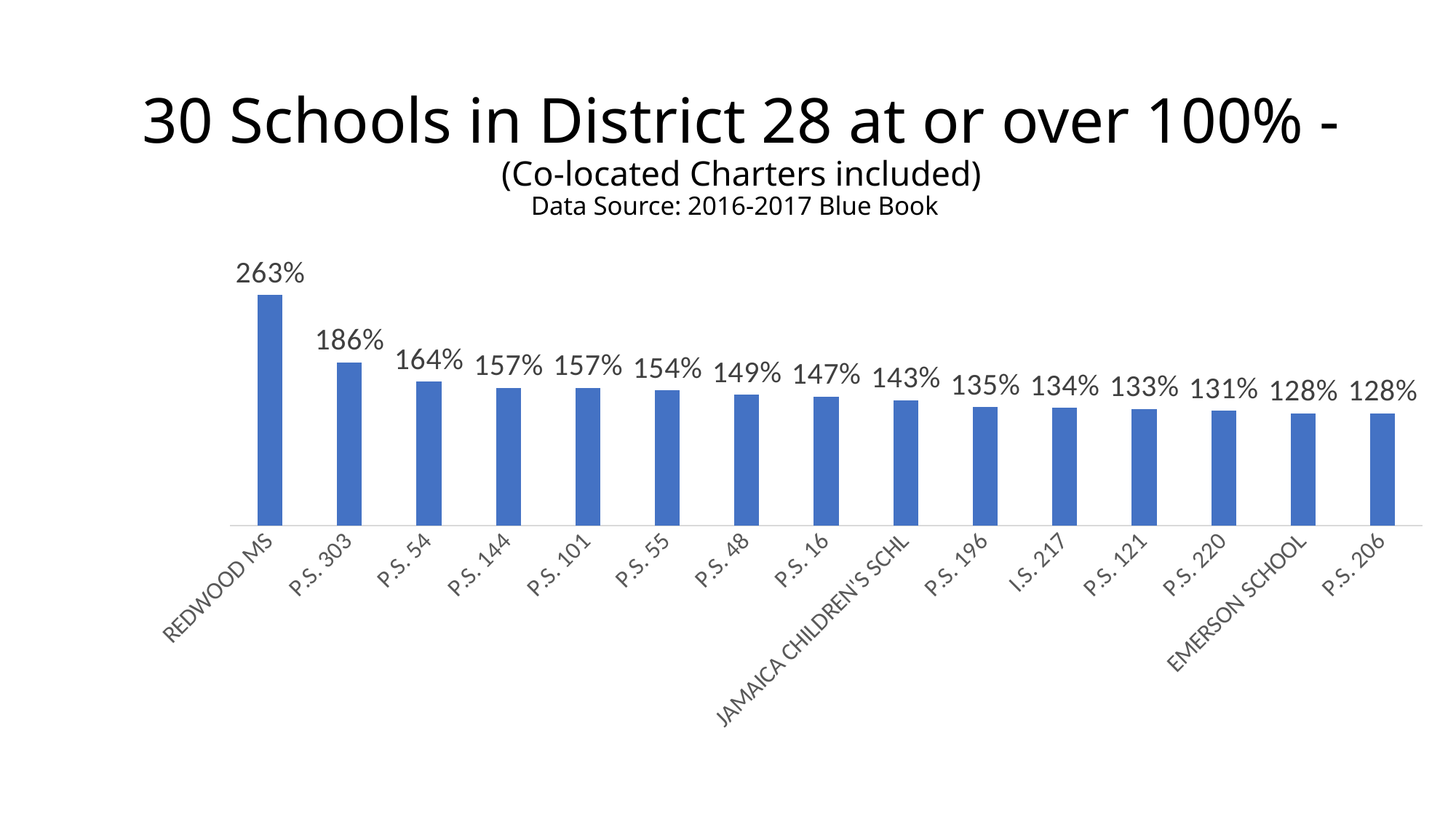
What is the value for P.S. 303? 186% What is the value for REDWOOD MS? 263% What is the value for JAMAICA CHILDREN'S SCHL? 143% What is the value for EMERSON SCHOOL? 128% What kind of chart is shown on the slide? bar chart Which school has the highest value? REDWOOD MS Do the values rise or fall from left to right along the x axis? fall What data source is cited under the chart title? 2016-2017 Blue Book What is the difference between the values for REDWOOD MS and P.S. 303? 77% How many schools are shown in the chart? 15 What is the difference between the values for P.S. 54 and P.S. 196? 29% Which is larger, the value for P.S. 55 or the value for I.S. 217? P.S. 55